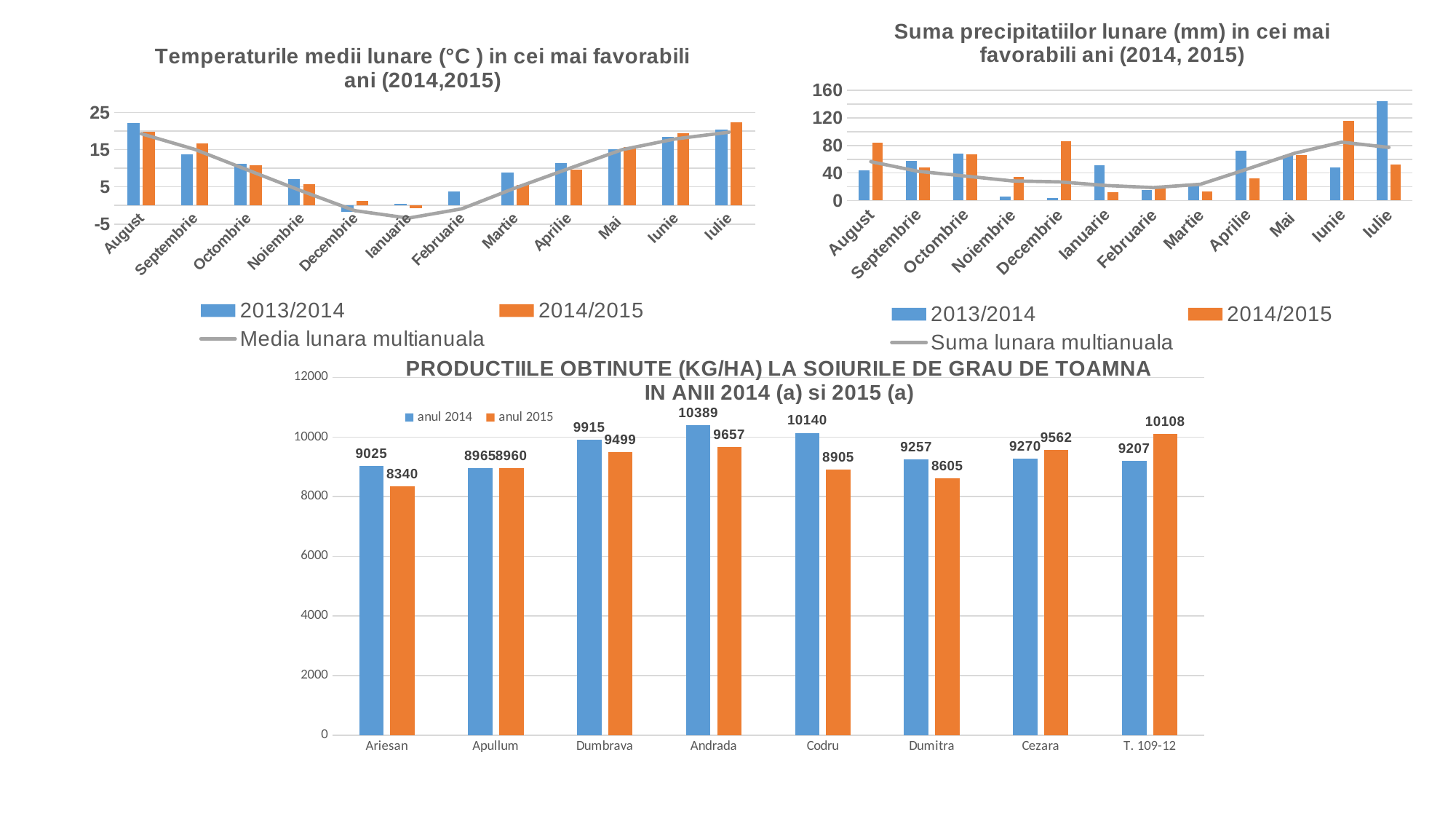
In the bottom chart (PRODUCTIILE OBTINUTE), what is the value for Andrada in anul 2014? 10389 In the bottom chart (PRODUCTIILE OBTINUTE), which is larger for Cezara: anul 2014 or anul 2015? anul 2015 In the top-right chart (Suma precipitatiilor lunare), how many months are shown on the x axis? 12 In the bottom chart (PRODUCTIILE OBTINUTE), which variety has the highest value for anul 2014? Andrada In the bottom chart (PRODUCTIILE OBTINUTE), how many wheat varieties are shown on the x axis? 8 What kind of chart is the bottom chart (PRODUCTIILE OBTINUTE)? bar chart In the top-left chart (Temperaturile medii lunare), how many series does the legend list? 3 In the bottom chart (PRODUCTIILE OBTINUTE), what is the value for T. 109-12 in anul 2015? 10108 In the bottom chart (PRODUCTIILE OBTINUTE), which variety has the lowest value for anul 2015? Ariesan In the top-right chart (Suma precipitatiilor lunare), is the 2013/2014 value for Iulie greater or less than 120? greater In the top-left chart (Temperaturile medii lunare), is the 2013/2014 value for August greater or less than 15? greater In the bottom chart (PRODUCTIILE OBTINUTE), what is the difference between the anul 2014 and anul 2015 values for Codru? 1235